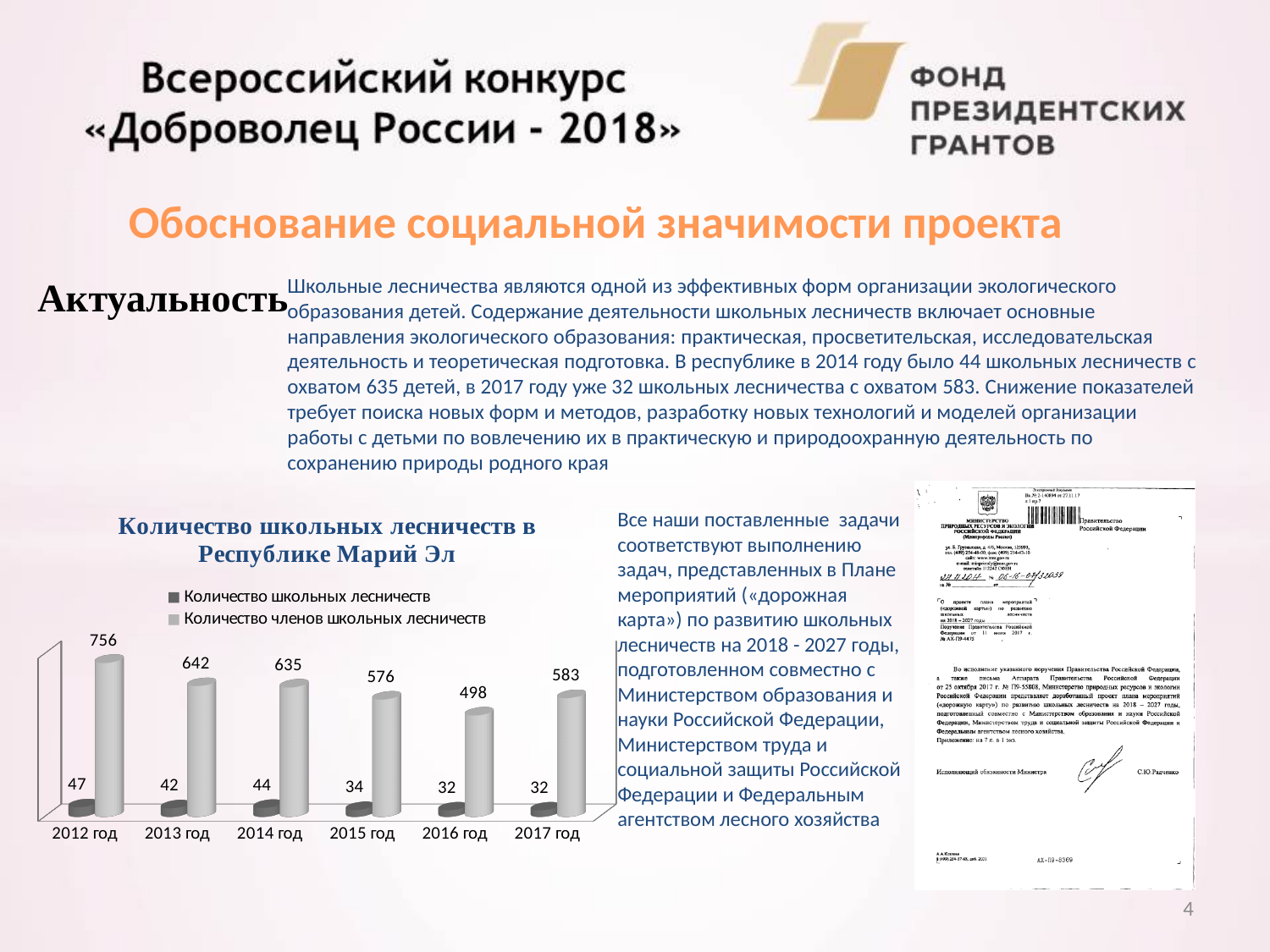
What is the value of 'Количество школьных лесничеств' for 2015 год? 34 What is the value of 'Количество членов школьных лесничеств' for 2016 год? 498 What is the title of the chart on the slide? Количество школьных лесничеств в Республике Марий Эл How many years (categories) are shown on the x axis of the chart? 6 What type of chart is shown on the slide? bar chart Which is larger: 'Количество членов школьных лесничеств' in 2013 год or in 2014 год? 2013 год What is the difference between 'Количество членов школьных лесничеств' in 2012 год and 2017 год? 173 What is the value of 'Количество членов школьных лесничеств' for 2012 год? 756 In which year is 'Количество членов школьных лесничеств' the lowest? 2016 год How many series does the chart legend list? 2 In which year is 'Количество школьных лесничеств' the highest? 2012 год Does 'Количество школьных лесничеств' generally rise or fall from 2012 год to 2017 год? fall